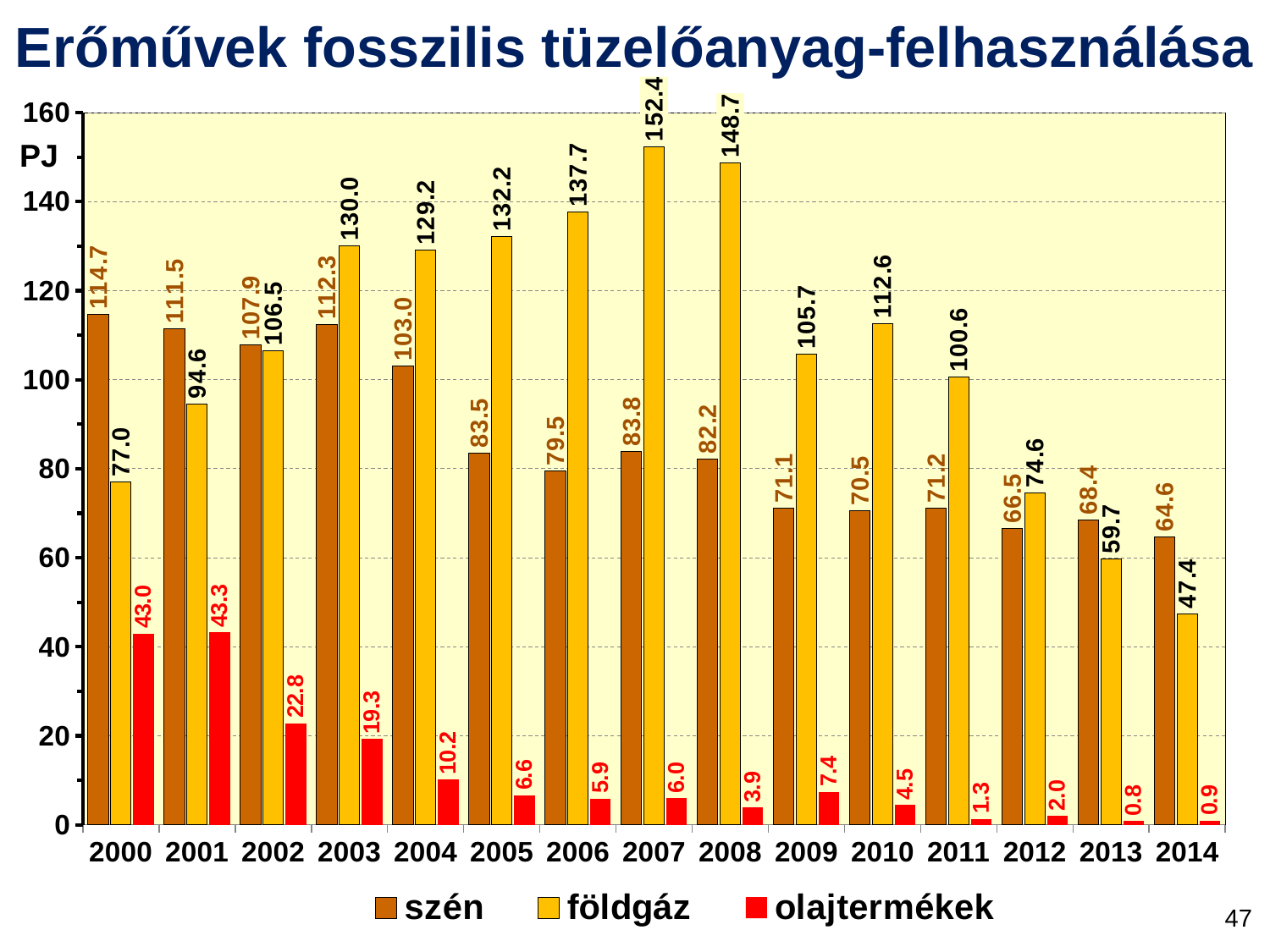
In which year is the földgáz value highest? 2007 What is the olajtermékek value for 2002? 22.8 What is the difference between the földgáz value in 2007 and in 2008? 3.7 What is the difference between the szén value in 2000 and in 2014? 50.1 In 2003, which is larger: szén or földgáz? földgáz How many years are shown on the x axis? 15 Does the szén value rise or fall from 2000 to 2014? fall What kind of chart is shown on the slide? bar chart In which year is the szén value lowest? 2014 What is the földgáz value for 2007? 152.4 How many series does the legend list? 3 What is the szén value for 2000? 114.7